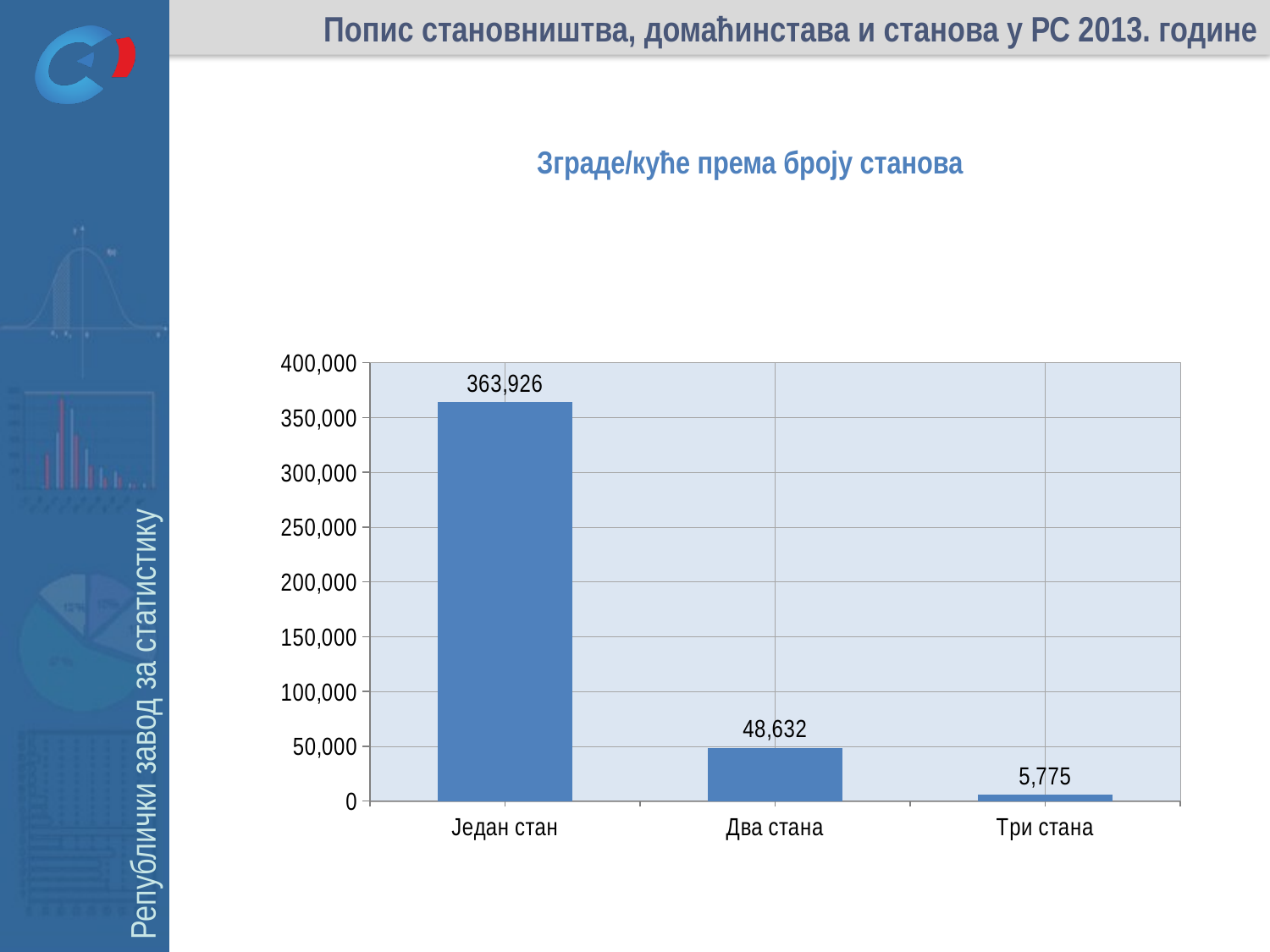
What is the value for Три стана? 5,775 What is the difference between the values for Два стана and Три стана? 42,857 How many categories are shown on the x axis? 3 What is the value for Два стана? 48,632 Is the value for Два стана greater or less than 100,000? less What kind of chart is shown on the slide? bar chart Which is larger, the value for Два стана or the value for Три стана? Два стана Which category has the lowest value? Три стана What is the value for Један стан? 363,926 Which category has the highest value? Један стан Do the values rise or fall from left to right along the x axis? fall What is the difference between the values for Један стан and Два стана? 315,294